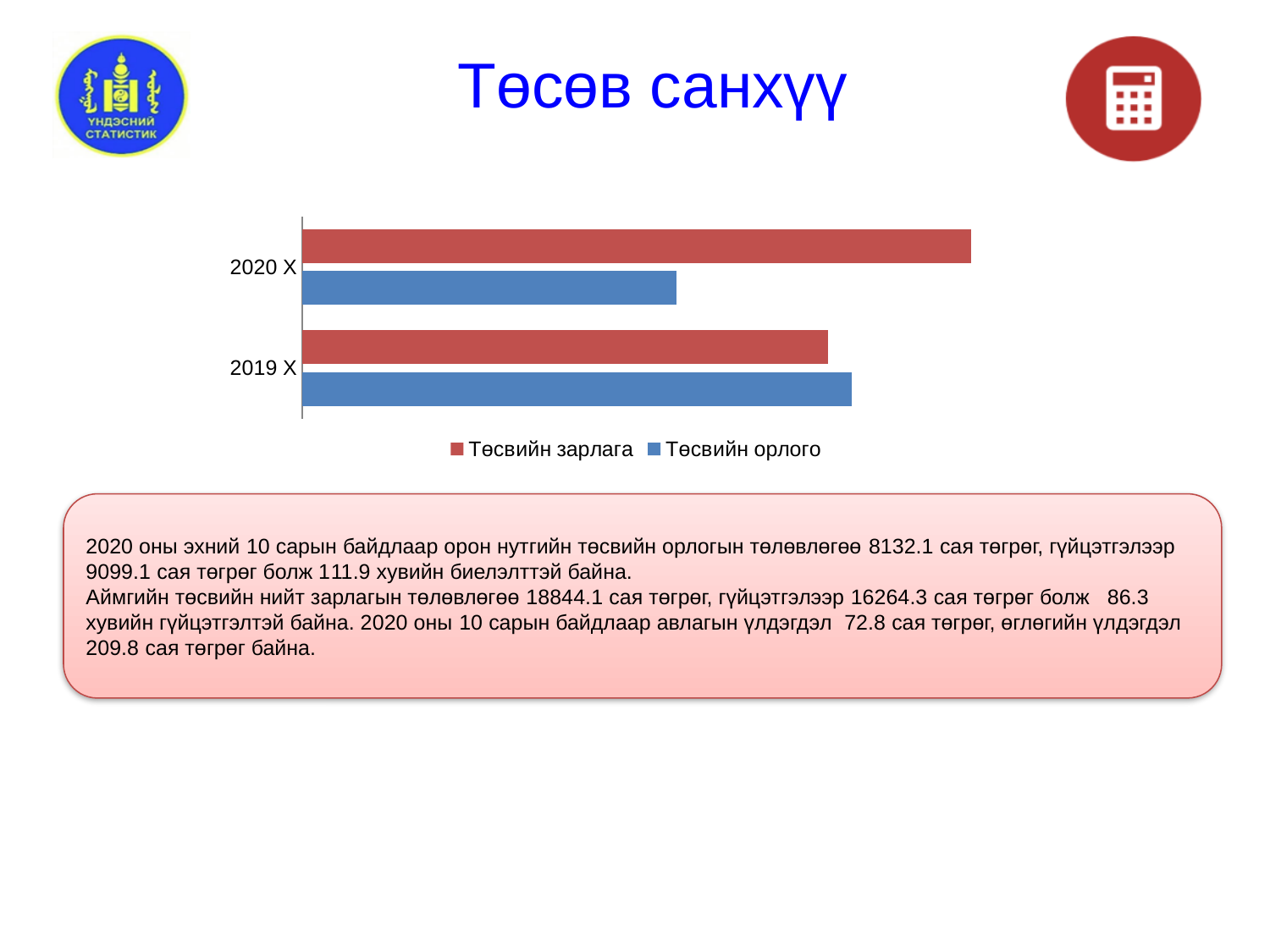
Does Төсвийн зарлага rise or fall from 2019 X to 2020 X? Rise For 2020 X, which is larger: Төсвийн зарлага or Төсвийн орлого? Төсвийн зарлага For Төсвийн орлого, which category has the higher value: 2020 X or 2019 X? 2019 X Which series is shown in blue on the chart? Төсвийн орлого Which category has the highest Төсвийн зарлага value? 2020 X Does Төсвийн орлого rise or fall from 2019 X to 2020 X? Fall What kind of chart is shown on the slide? Bar chart Which series is shown in red on the chart? Төсвийн зарлага Which category has the lowest Төсвийн орлого value? 2020 X How many series does the chart legend list? 2 How many categories are shown on the chart's vertical axis? 2 For Төсвийн зарлага, which category has the higher value: 2020 X or 2019 X? 2020 X